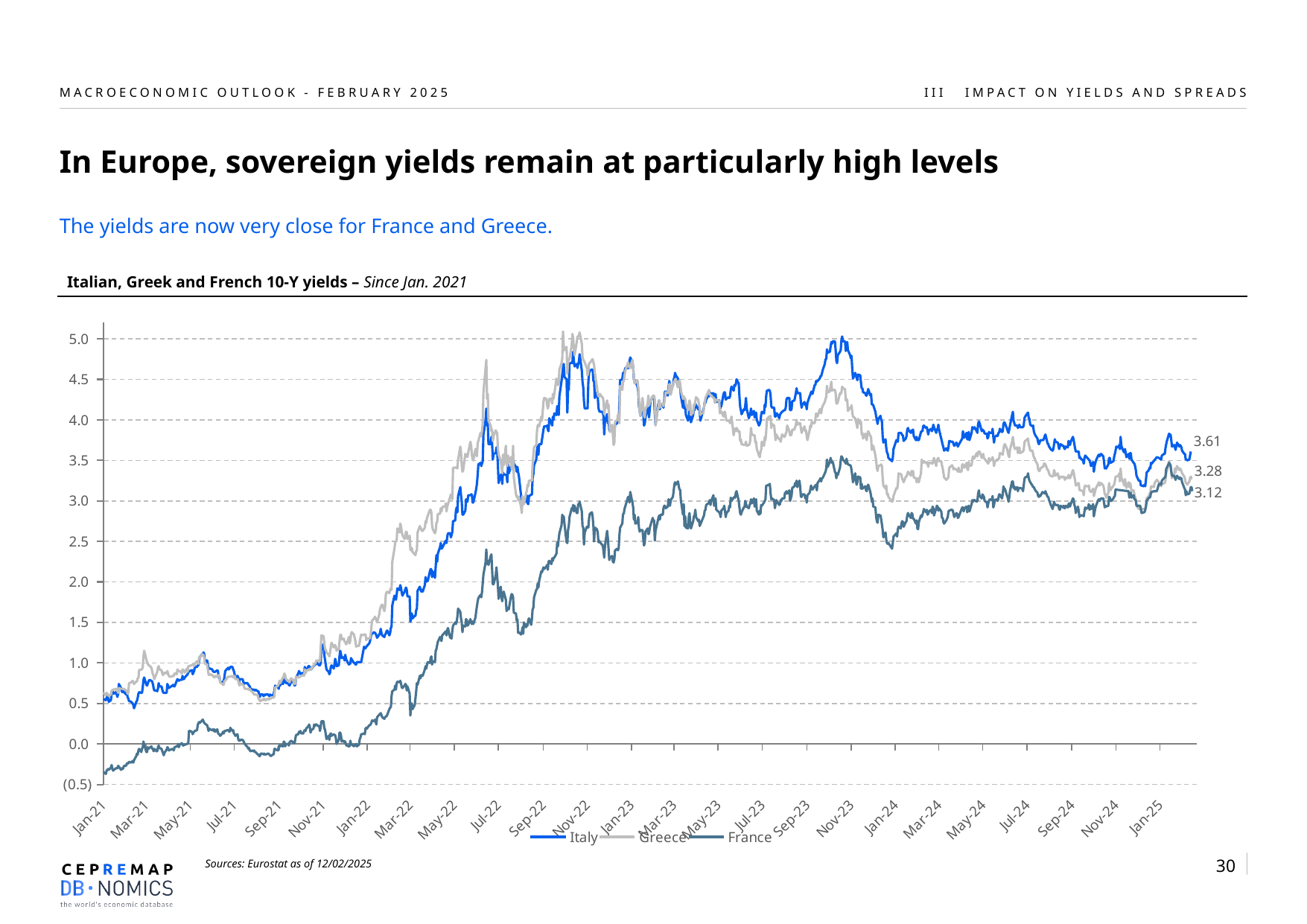
Is the latest value for Italy or for France larger? Italy What is the difference between the latest values for Greece and France? 0.16 What is the difference between the latest values for Italy and Greece? 0.33 What is the latest value shown for France's 10-Y yield? 3.12 Does France's 10-Y yield rise or fall overall from Jan-21 to Jan-25? Rise What kind of chart is shown on the slide? Line chart How many series does the legend list? 3 Which country has the lowest latest 10-Y yield value on the chart? France Is the value for France in Jan-21 greater or less than 0.0? less Which country has the highest latest 10-Y yield value on the chart? Italy What is the latest value shown for Greece's 10-Y yield? 3.28 What is the latest value shown for Italy's 10-Y yield? 3.61